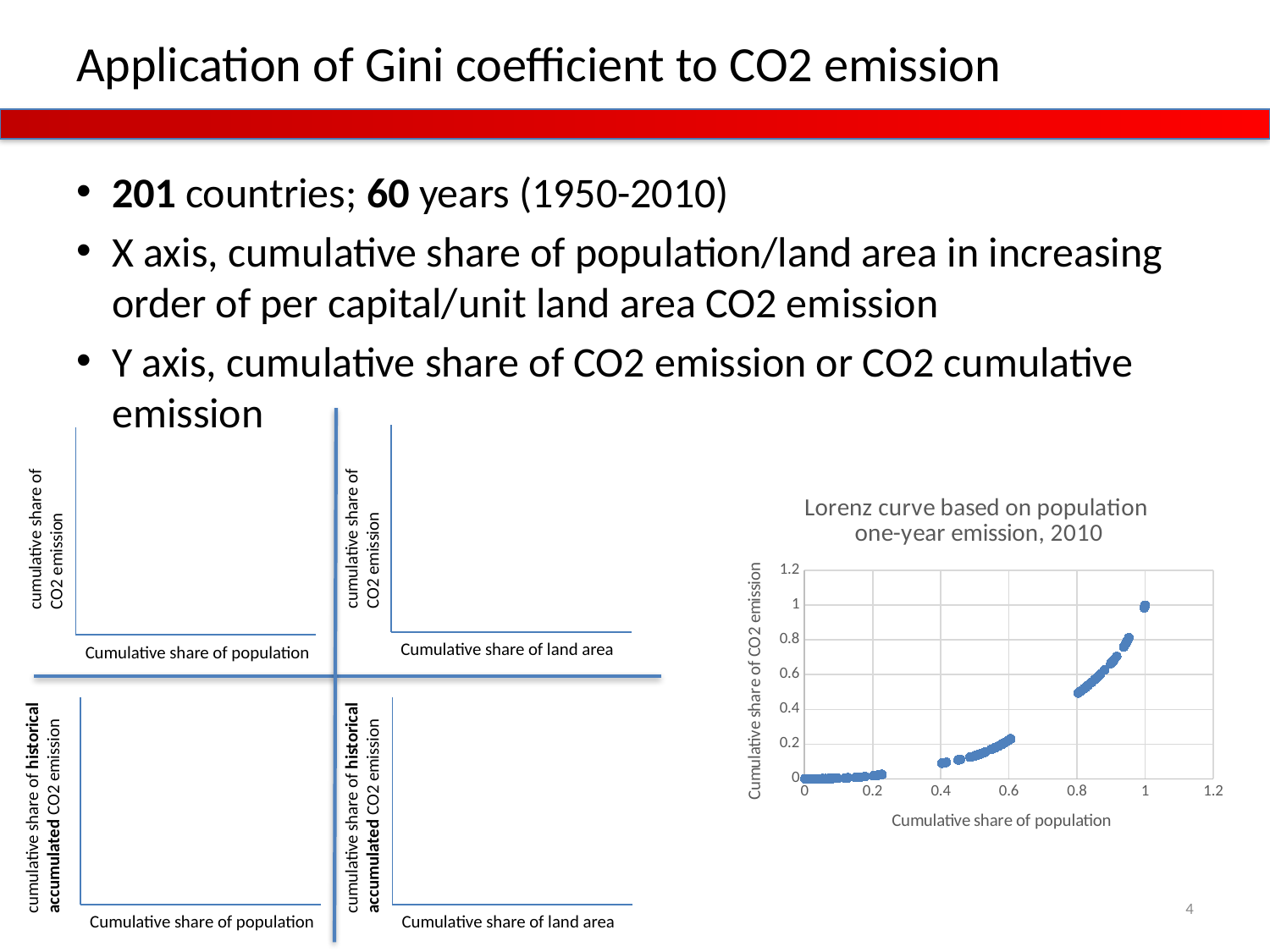
In the 'Lorenz curve based on population one-year emission, 2010' chart, is the cumulative share of CO2 emission at a cumulative share of population of 0.9 greater or less than 0.4? greater In the 'Lorenz curve based on population one-year emission, 2010' chart, is the cumulative share of CO2 emission at a cumulative share of population of 0.8 greater or less than 0.6? less In the 'Lorenz curve based on population one-year emission, 2010' chart, is the cumulative share of CO2 emission at a cumulative share of population of 0.6 greater or less than 0.4? less In the 'Lorenz curve based on population one-year emission, 2010' chart, what is the label of the x axis? Cumulative share of population In the 'Lorenz curve based on population one-year emission, 2010' chart, what is the highest tick value shown on the y axis? 1.2 In the 'Lorenz curve based on population one-year emission, 2010' chart, do the plotted values rise or fall as the cumulative share of population increases? rise In the 'Lorenz curve based on population one-year emission, 2010' chart, which has the higher cumulative share of CO2 emission: the point at a cumulative share of population of 0.4 or the point at 0.8? 0.8 What kind of chart is the 'Lorenz curve based on population one-year emission, 2010' chart? scatter chart What is the title of the chart on the right side of the slide? Lorenz curve based on population one-year emission, 2010